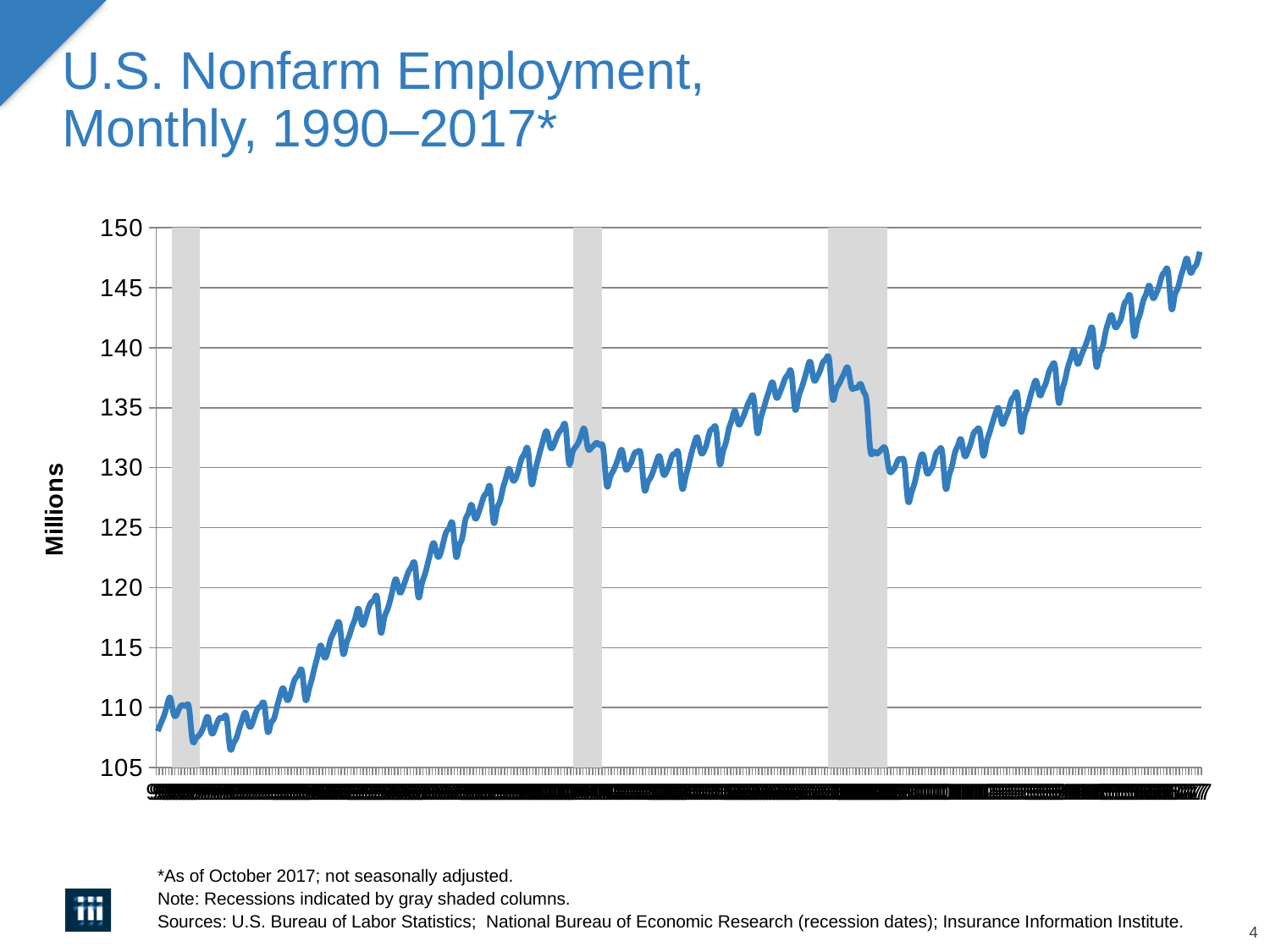
Is the value at the end of the series (October 2017) greater or less than 145? greater What is the title of the chart on the slide? U.S. Nonfarm Employment, Monthly, 1990–2017* Is the lowest value in the series greater or less than 110? less Overall, do the values rise or fall from the start of the series in 1990 to the end in 2017? Rise How many gray shaded recession columns are shown on the chart? 3 What kind of chart is shown on the slide? Line chart What is the lowest tick value shown on the vertical axis? 105 Is the value at the end of the series (October 2017) larger or smaller than the value at the start of the series (1990)? Larger What is the highest tick value shown on the vertical axis? 150 What is the label on the vertical axis of the chart? Millions Is the highest value reached in the series greater or less than 145? greater